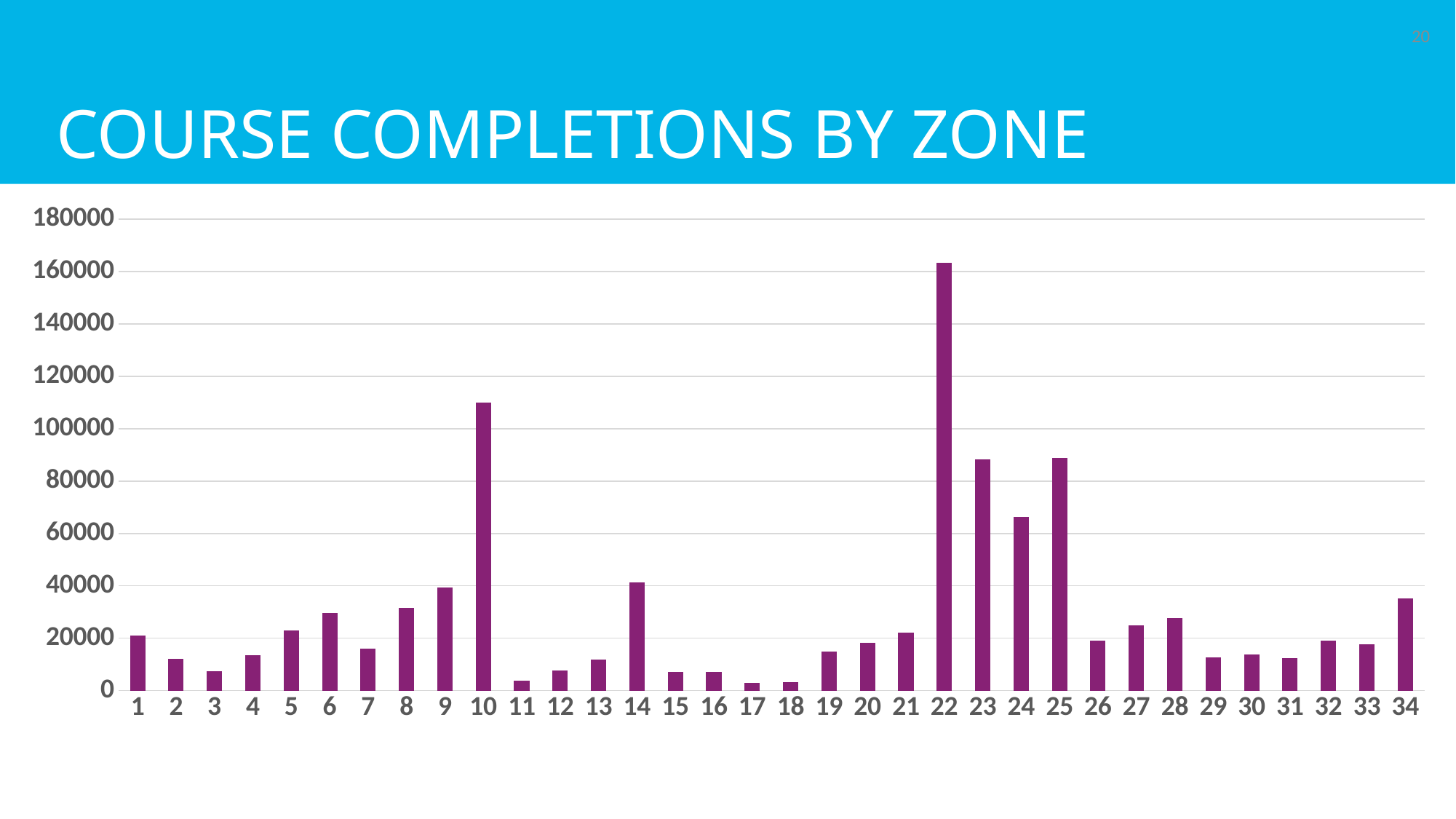
Is the value for zone 22 greater or less than 140000? greater Which has more course completions, zone 6 or zone 7? 6 Which has more course completions, zone 23 or zone 24? 23 Is the value for zone 34 greater or less than 40000? less Is the value for zone 10 greater or less than 100000? greater How many zones are shown on the x axis of the chart? 34 Which has more course completions, zone 10 or zone 22? 22 Which zone has the highest number of course completions? 22 What kind of chart is shown on the slide? bar chart What is the title of the chart? COURSE COMPLETIONS BY ZONE